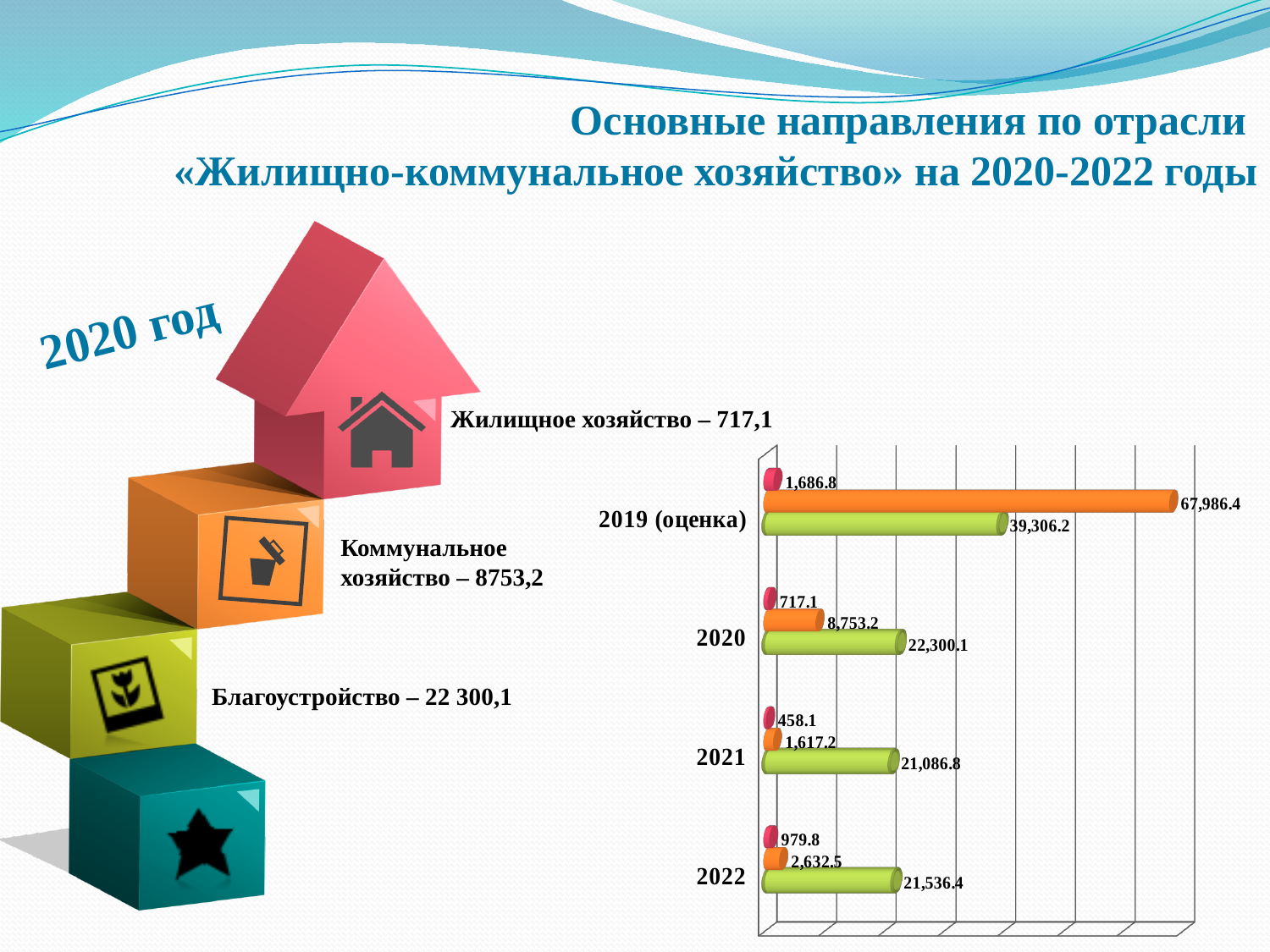
What is the difference between the green bar values for 2020 and 2021? 1,213.3 Which year has the lowest value for the pink bar? 2021 Which is larger: the orange bar for 2021 or the orange bar for 2022? 2022 According to the slide text, which direction does the value 22 300,1 for 2020 correspond to? Благоустройство What is the value of the orange bar for 2022? 2,632.5 Which year has the highest value for the green bar? 2019 (оценка) What type of chart is shown on the slide? bar chart How many categories (years) are shown on the chart? 4 Does the orange bar value rise or fall from 2019 (оценка) to 2021? fall What is the value of the pink bar for 2021? 458.1 What is the value of the orange bar for 2019 (оценка)? 67,986.4 What is the value of the green bar for 2020? 22,300.1